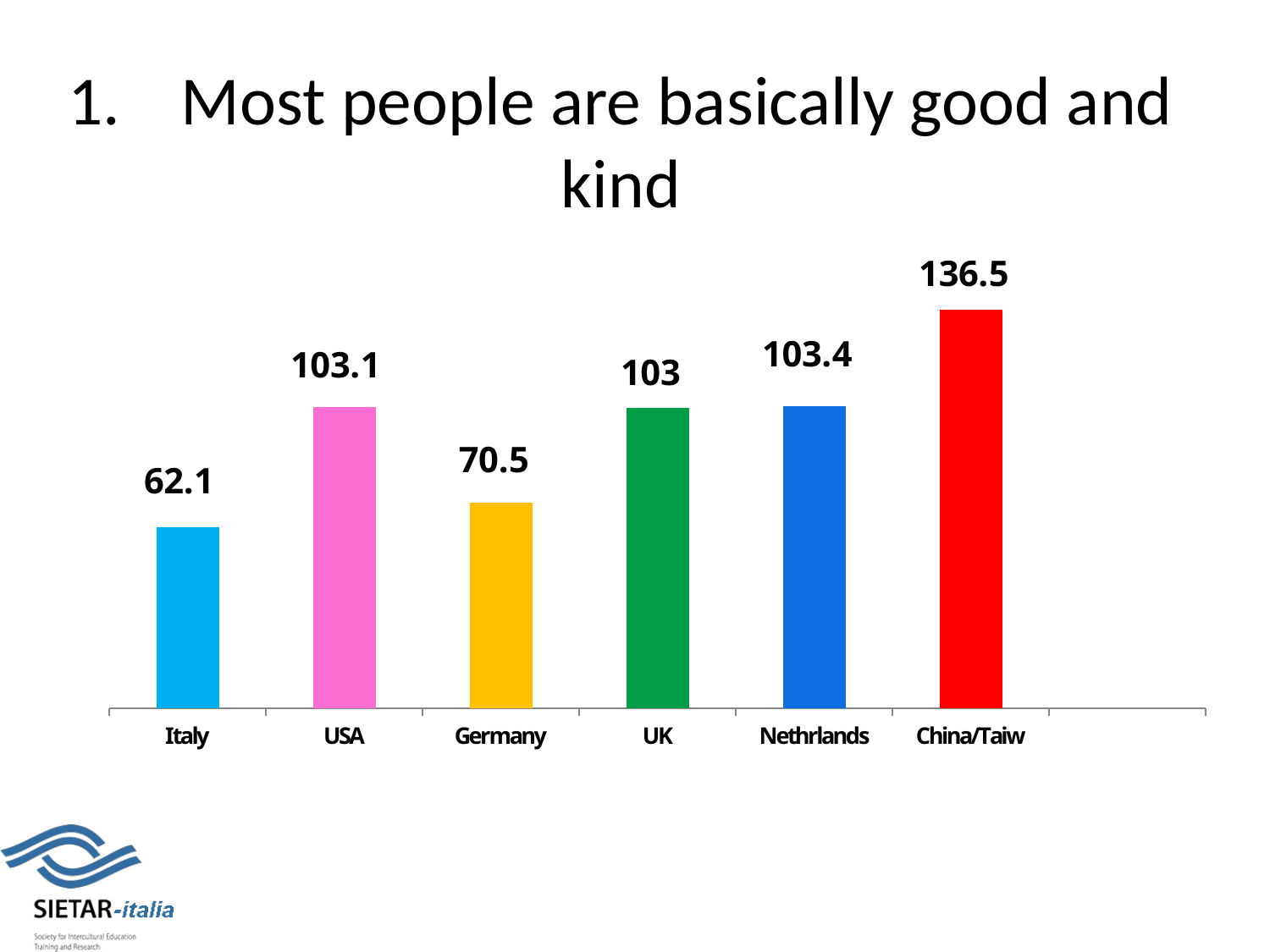
Which is larger, the value for USA or the value for Germany? USA What is the value for UK? 103 What is the difference between the values for China/Taiw and Italy? 74.4 What kind of chart is shown on the slide? Bar chart What is the value for Italy? 62.1 What is the difference between the values for Germany and Italy? 8.4 What is the value for China/Taiw? 136.5 Which category has the lowest value? Italy What is the value for Germany? 70.5 Which category has the highest value? China/Taiw What colour is the bar for China/Taiw? Red How many categories are shown in the chart? 6